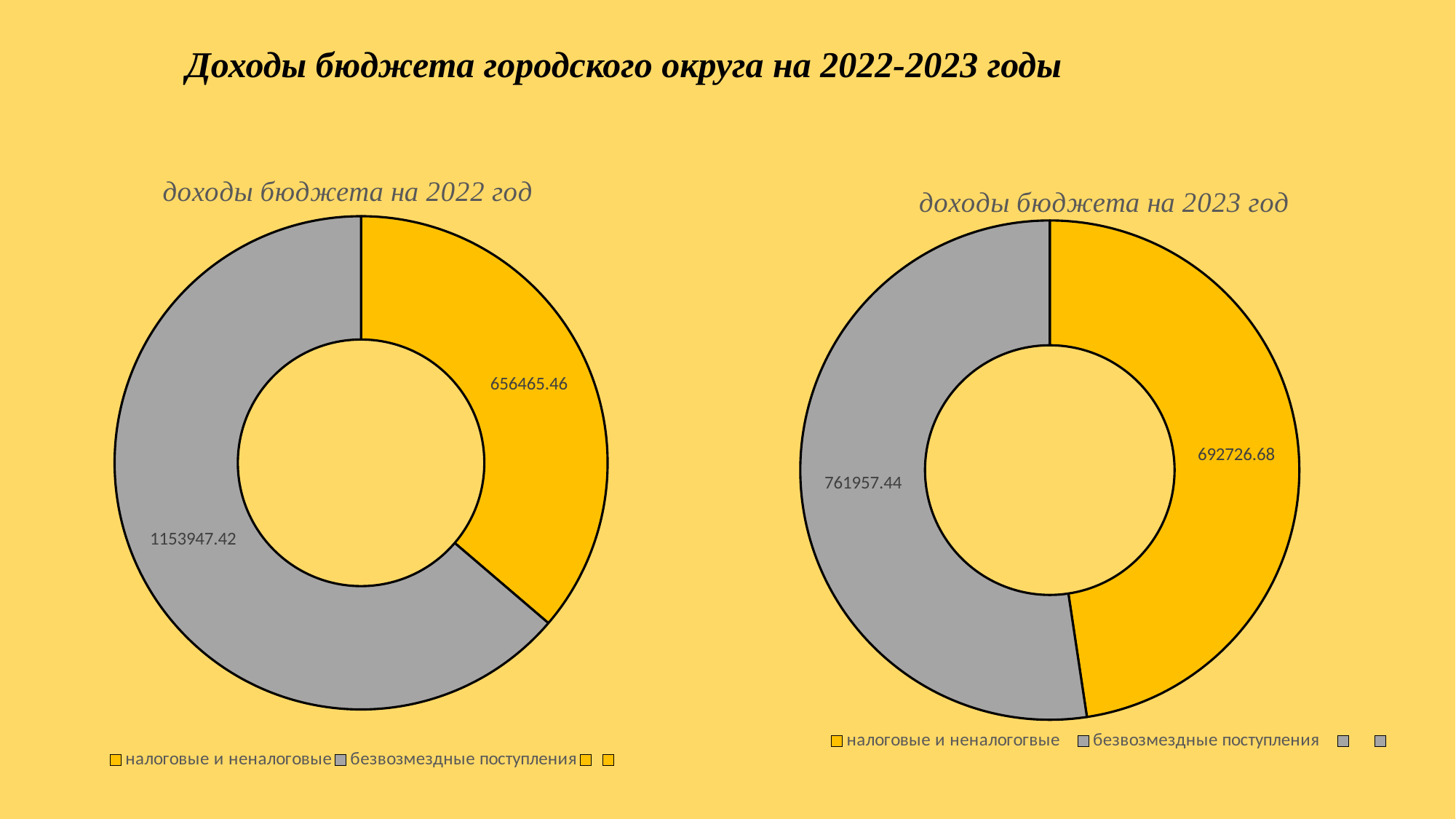
In the chart 'доходы бюджета на 2023 год', what is the value for 'безвозмездные поступления'? 761957.44 What kind of chart is 'доходы бюджета на 2023 год'? doughnut chart In the chart 'доходы бюджета на 2023 год', what is the value for 'налоговые и неналогогвые'? 692726.68 In the chart 'доходы бюджета на 2022 год', which category has the largest value? безвозмездные поступления Which is larger: 'налоговые и неналоговые' in the 2022 chart or 'налоговые и неналогогвые' in the 2023 chart? 2023 chart (692726.68) In the chart 'доходы бюджета на 2022 год', what is the value for 'безвозмездные поступления'? 1153947.42 What is the main title of the slide? Доходы бюджета городского округа на 2022-2023 годы In the chart 'доходы бюджета на 2022 год', what is the value for 'налоговые и неналоговые'? 656465.46 In the chart 'доходы бюджета на 2023 год', what is the difference between 'безвозмездные поступления' and 'налоговые и неналогогвые'? 69230.76 In the chart 'доходы бюджета на 2023 год', which category has the smallest value? налоговые и неналогогвые In the chart 'доходы бюджета на 2022 год', what is the total of the two labelled slices? 1810412.88 In the chart 'доходы бюджета на 2022 год', what is the difference between 'безвозмездные поступления' and 'налоговые и неналоговые'? 497481.96